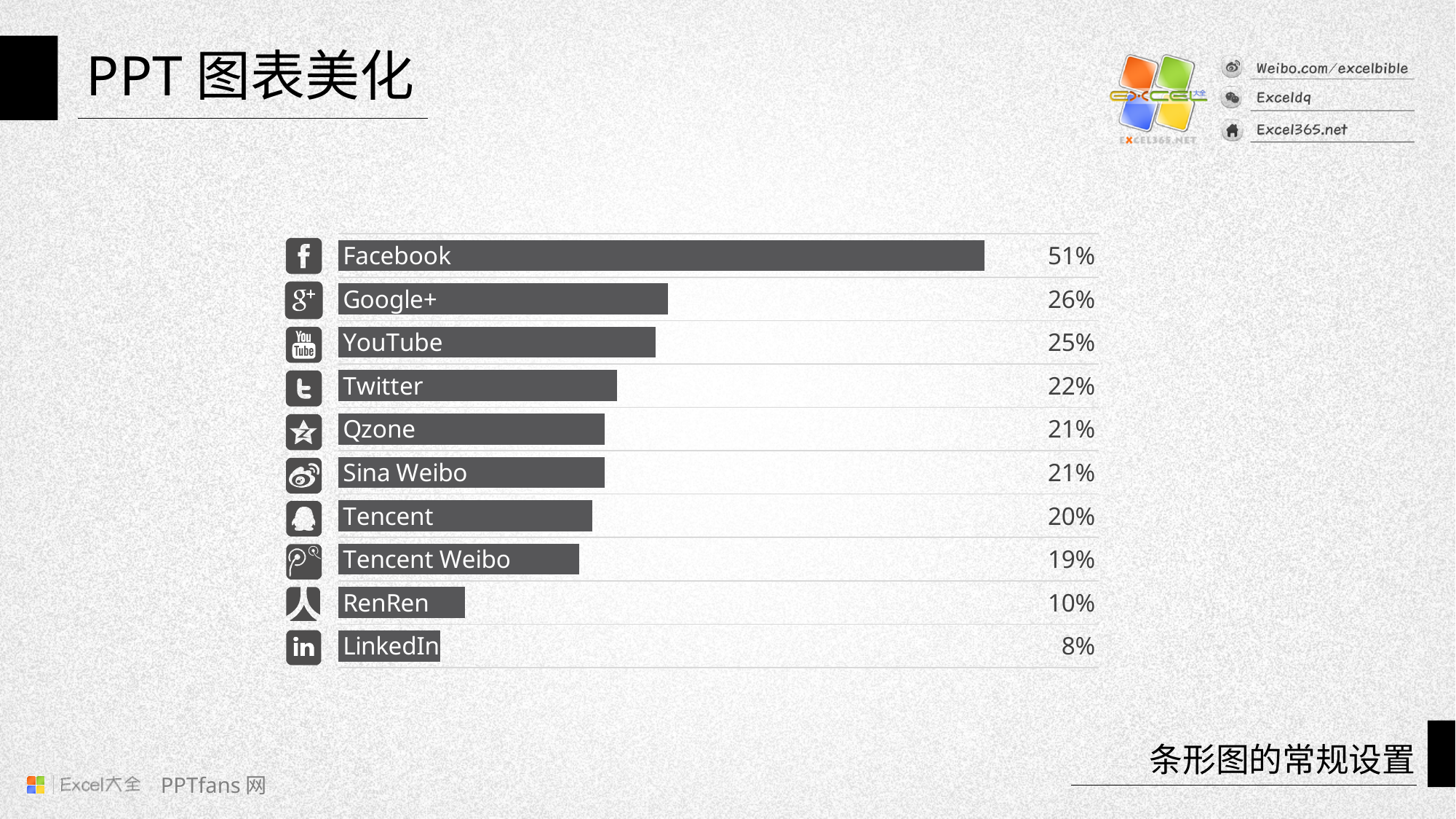
Which category has the highest value? Facebook What is the value for LinkedIn? 8% What is the difference between the values for Facebook and Google+? 25% What is the value for Facebook? 51% Which category has the lowest value? LinkedIn What kind of chart is shown on the slide? Bar chart What is the difference between the values for RenRen and LinkedIn? 2% What is the value for Sina Weibo? 21% Which is larger, the value for Twitter or the value for Tencent? Twitter How many categories are shown in the chart? 10 Do the values rise or fall going from the top bar to the bottom bar? Fall What is the value for Tencent Weibo? 19%